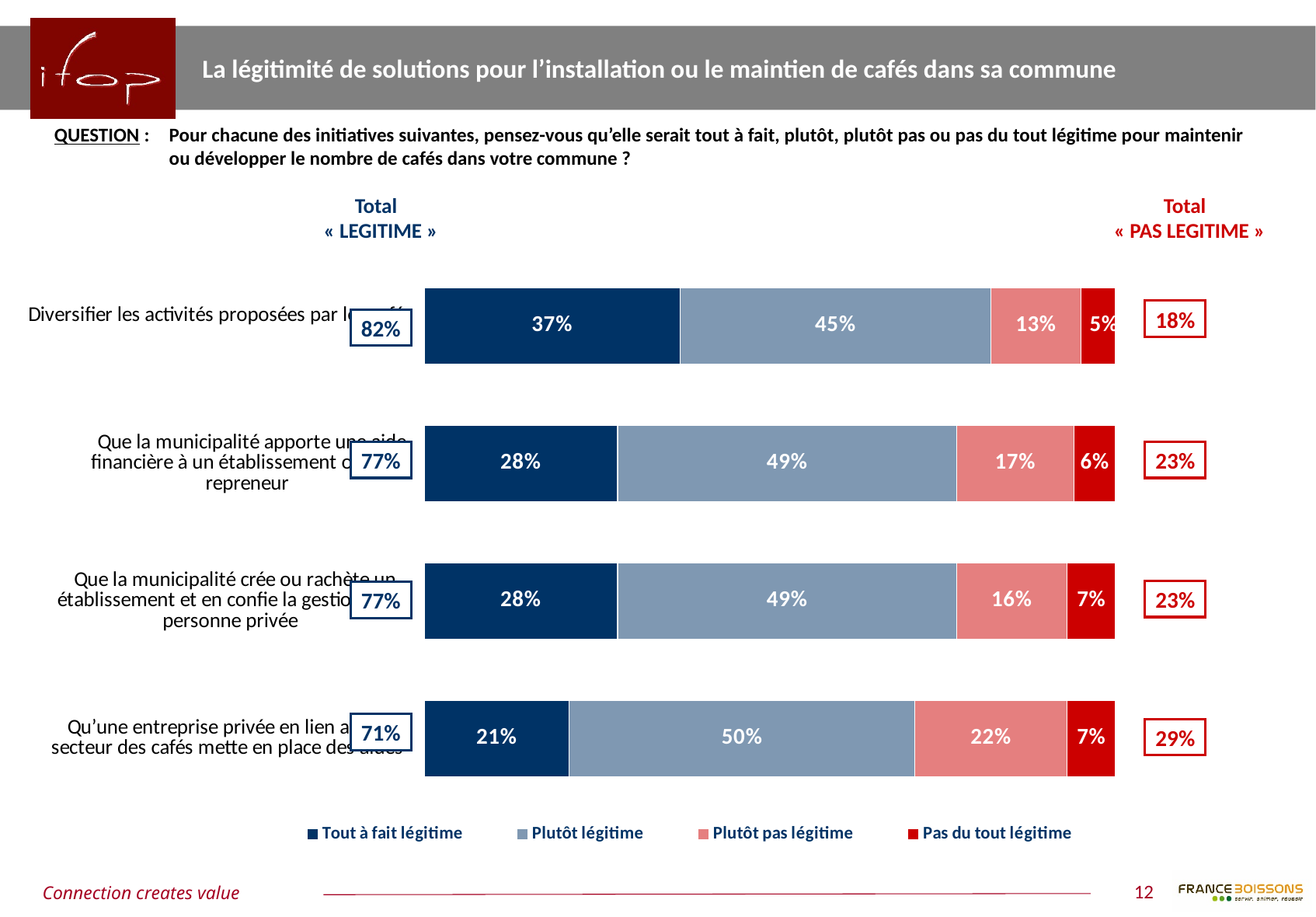
What is the "Plutôt légitime" value for the initiative "Qu'une entreprise privée en lien avec le secteur des cafés mette en place des aides"? 50% What is the difference in the "Plutôt pas légitime" share between "Qu'une entreprise privée en lien avec le secteur des cafés mette en place des aides" and "Diversifier les activités proposées par le café"? 9 points What type of chart is shown on the slide? Stacked bar chart Which initiative has the lowest "Tout à fait légitime" share? Qu'une entreprise privée en lien avec le secteur des cafés mette en place des aides What percentage of respondents answered "Tout à fait légitime" for the initiative "Diversifier les activités proposées par le café"? 37% What is the Total « PAS LEGITIME » for the initiative "Qu'une entreprise privée en lien avec le secteur des cafés mette en place des aides"? 29% What is the Total « LEGITIME » for the initiative "Que la municipalité apporte une aide financière à un établissement ou repreneur"? 77% What is the combined share of "Tout à fait légitime" and "Plutôt légitime" for "Diversifier les activités proposées par le café"? 82% Which has the larger "Pas du tout légitime" share: "Diversifier les activités proposées par le café" or "Que la municipalité crée ou rachète un établissement et en confie la gestion à une personne privée"? Que la municipalité crée ou rachète un établissement et en confie la gestion à une personne privée How many initiatives are shown in the chart? 4 Which initiative has the highest Total « LEGITIME »? Diversifier les activités proposées par le café How many response categories does the legend list? 4